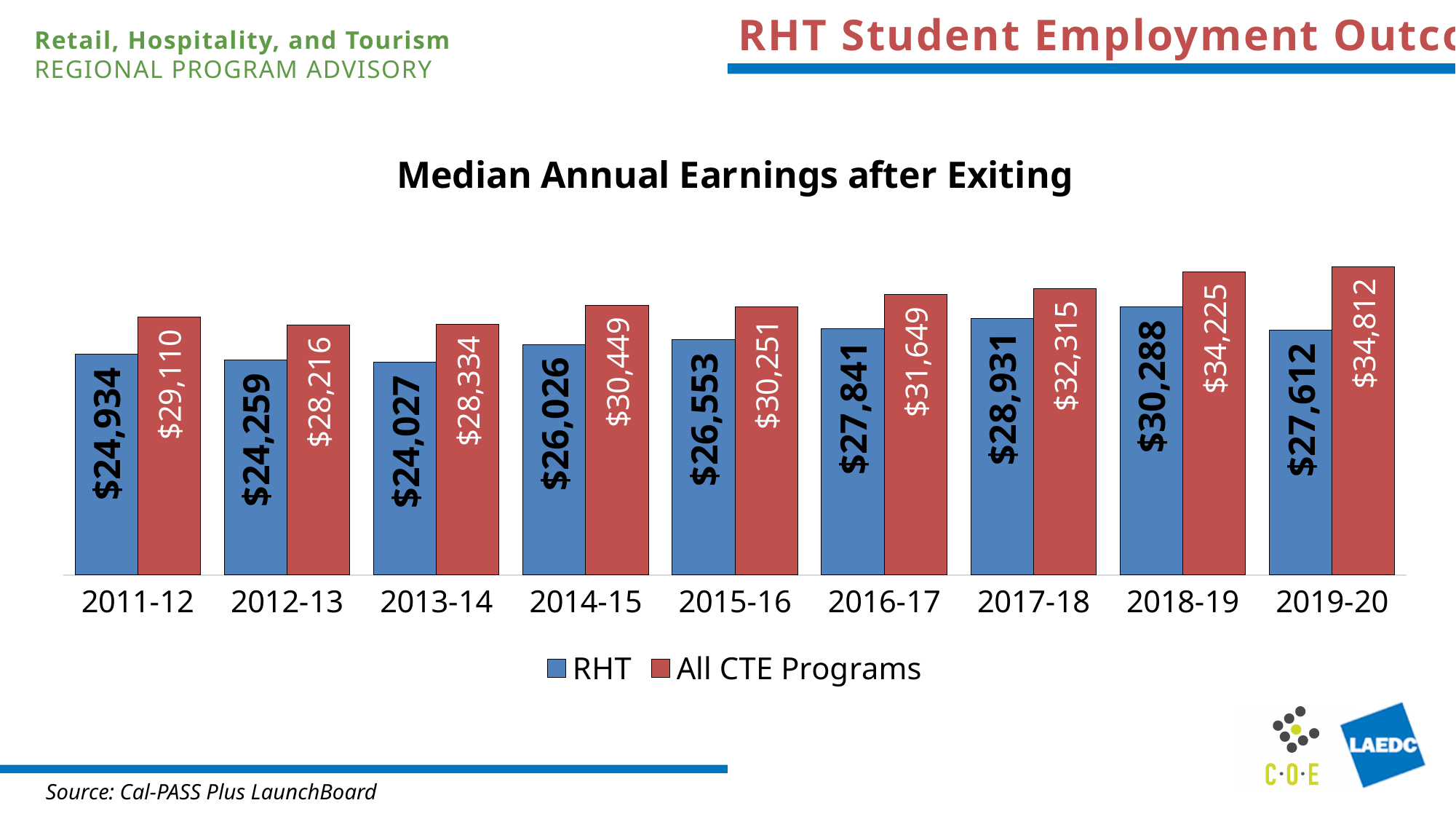
What is the median annual earnings for RHT in 2015-16? $26,553 In which year is the RHT median annual earnings lowest? 2013-14 What is the difference between All CTE Programs and RHT median annual earnings in 2019-20? $7,200 How many series does the legend list? 2 What is the median annual earnings for RHT in 2019-20? $27,612 What is the difference between All CTE Programs and RHT median annual earnings in 2011-12? $4,176 How many years are shown on the x axis? 9 What is the median annual earnings for All CTE Programs in 2017-18? $32,315 Which is larger in 2014-15: RHT or All CTE Programs median annual earnings? All CTE Programs What kind of chart is shown on the slide? Bar chart In which year is the RHT median annual earnings highest? 2018-19 In which year is the All CTE Programs median annual earnings highest? 2019-20